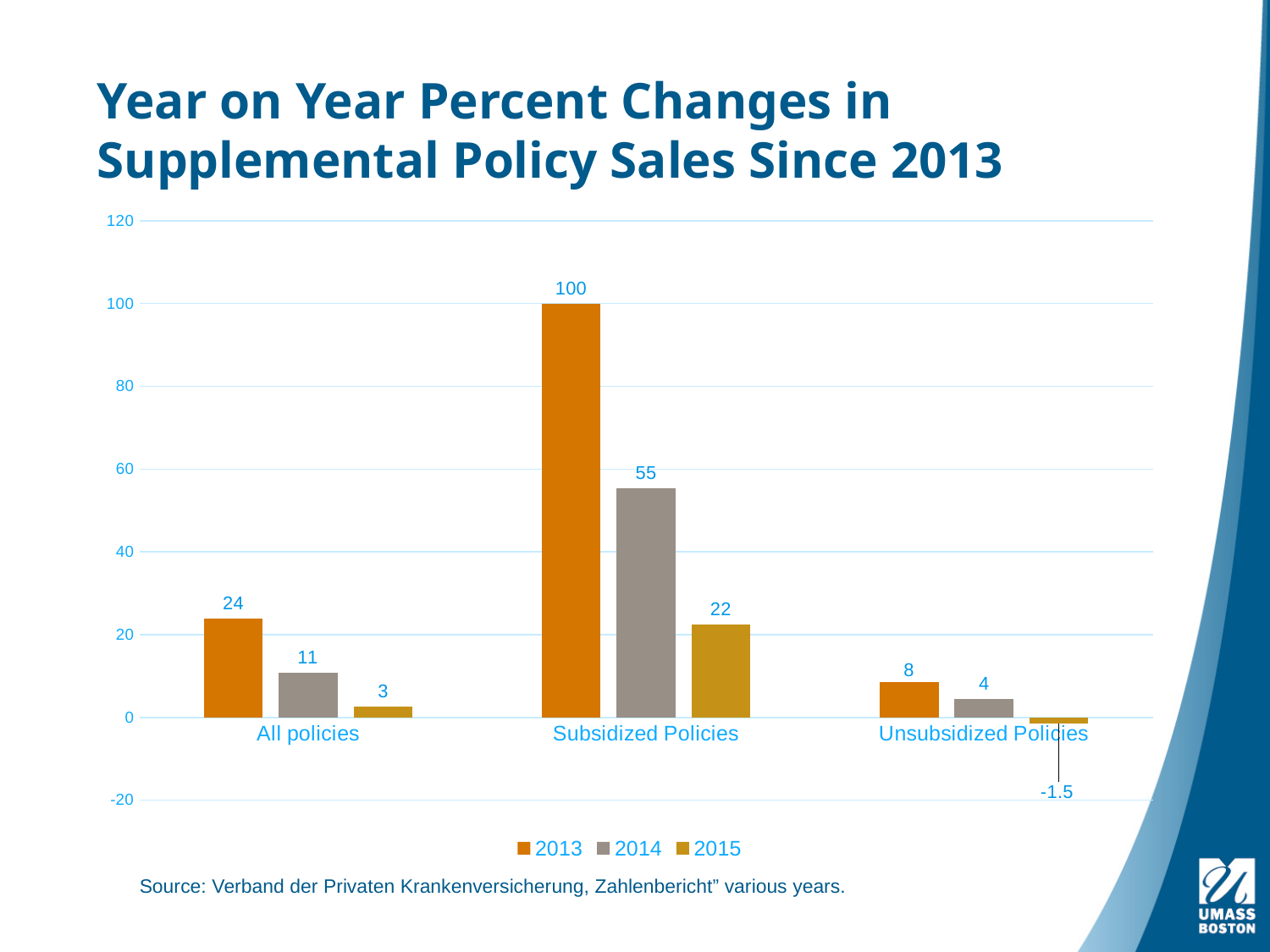
Which is larger, the 2015 value for All policies or the 2015 value for Subsidized Policies? Subsidized Policies Which category has the highest value in 2013? Subsidized Policies How many categories are shown on the x axis? 3 What is the value for Subsidized Policies in 2013? 100 Is the 2014 value for Subsidized Policies greater or less than 40? greater What is the title of the chart? Year on Year Percent Changes in Supplemental Policy Sales Since 2013 How many series does the legend list? 3 What is the value for All policies in 2014? 11 What is the value for Unsubsidized Policies in 2015? -1.5 What is the difference between the 2013 and 2014 values for Subsidized Policies? 45 Which category has the lowest value in 2015? Unsubsidized Policies What kind of chart is shown on the slide? bar chart